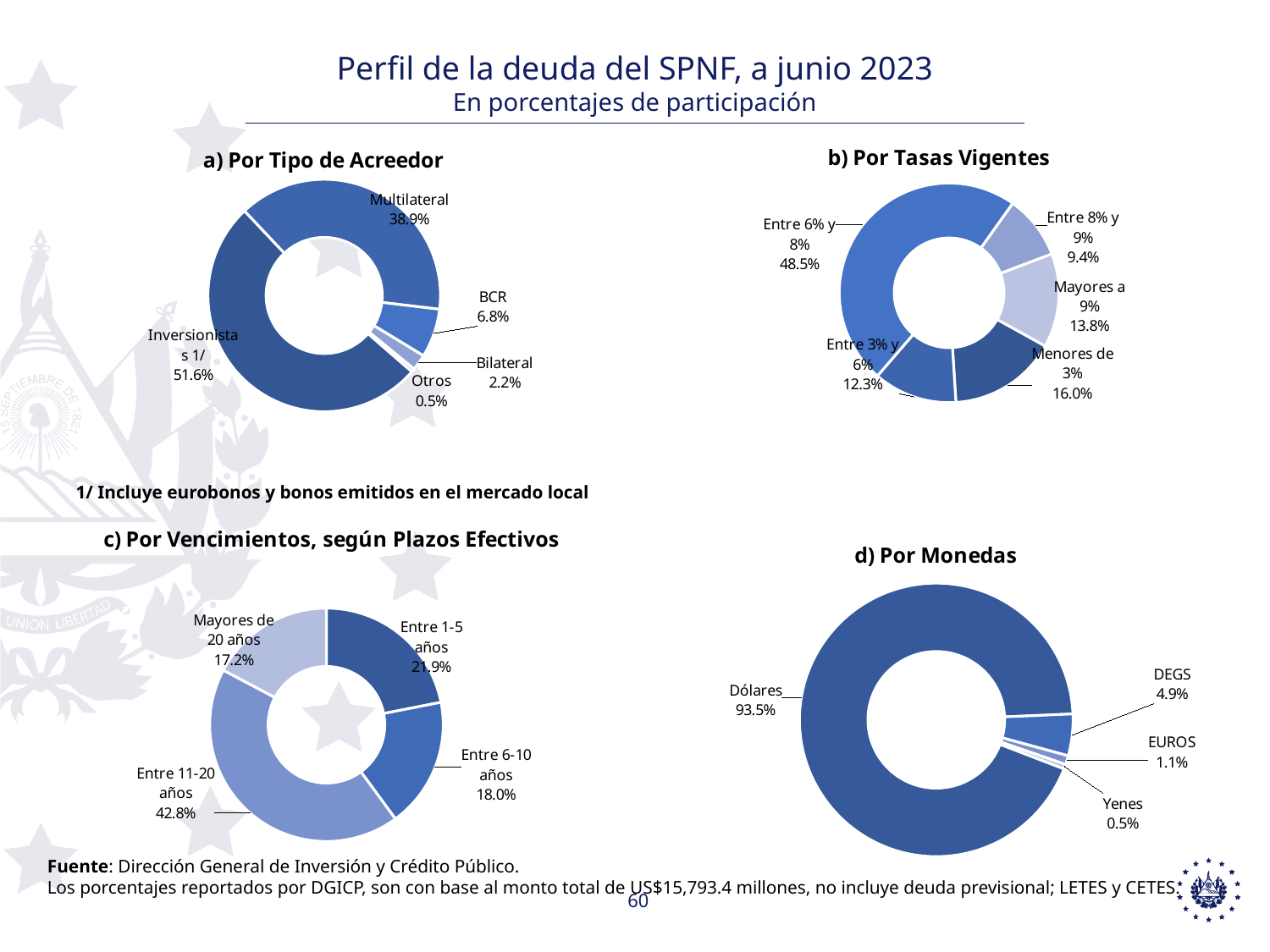
In the chart 'b) Por Tasas Vigentes', what is the difference between the shares for 'Mayores a 9%' and 'Entre 8% y 9%'? 4.4% In the chart 'b) Por Tasas Vigentes', what share is labelled for 'Menores de 3%'? 16.0% In the chart 'a) Por Tipo de Acreedor', what share is labelled for Multilateral? 38.9% In the chart 'a) Por Tipo de Acreedor', which category has the smallest share? Otros In the chart 'd) Por Monedas', what share is labelled for Dólares? 93.5% In the chart 'a) Por Tipo de Acreedor', which category has the largest share? Inversionistas 1/ In the chart 'b) Por Tasas Vigentes', which category has the largest share? Entre 6% y 8% How many categories are shown in the chart 'c) Por Vencimientos, según Plazos Efectivos'? 4 In the chart 'c) Por Vencimientos, según Plazos Efectivos', which is larger: 'Entre 1-5 años' or 'Entre 6-10 años'? Entre 1-5 años What kind of chart is 'd) Por Monedas'? Doughnut (pie) chart In the chart 'c) Por Vencimientos, según Plazos Efectivos', what share is labelled for 'Entre 11-20 años'? 42.8% In the chart 'd) Por Monedas', which currency has the smallest share? Yenes